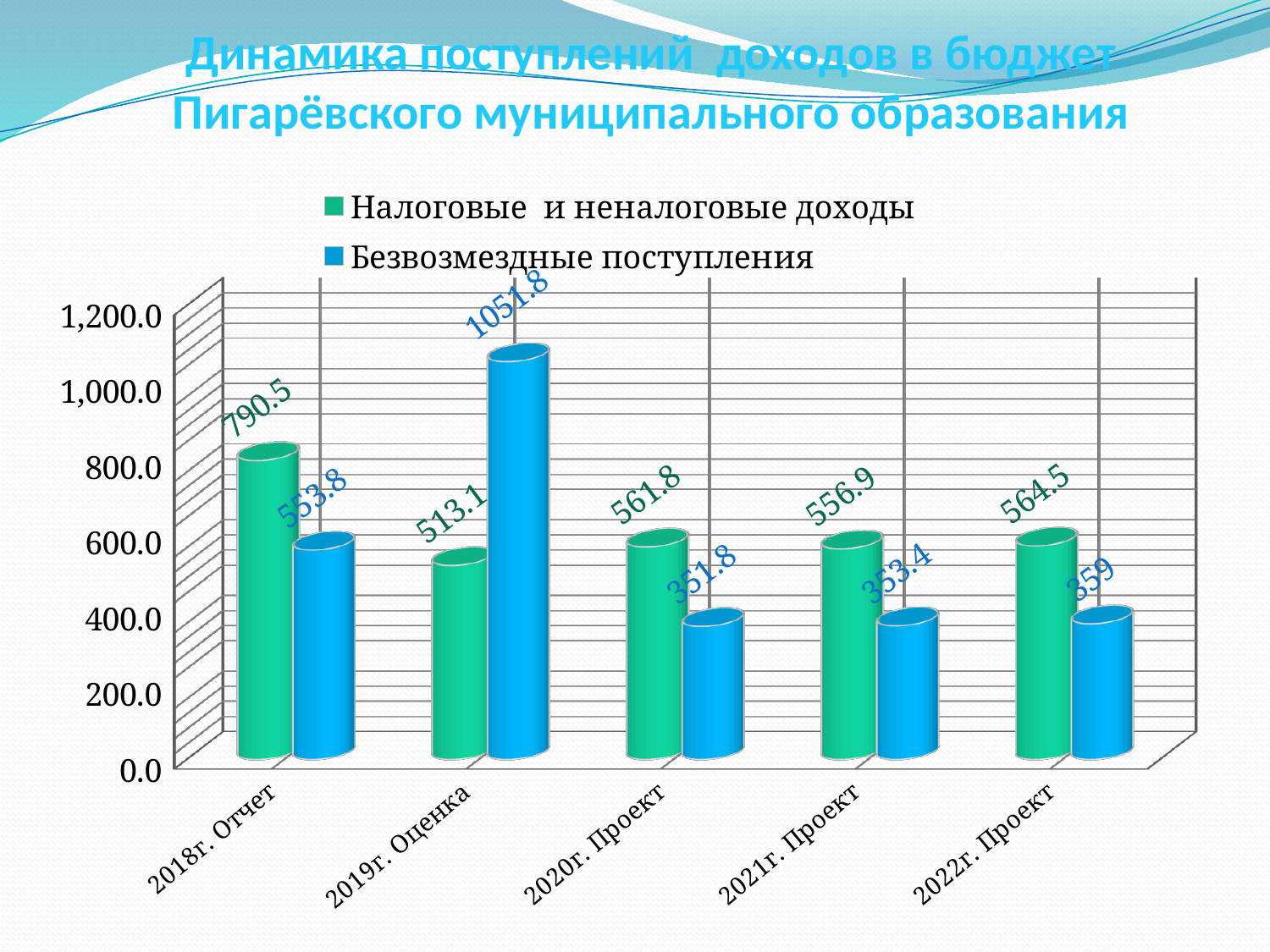
What is the value of Налоговые и неналоговые доходы for 2018г. Отчет? 790.5 Which category has the lowest value for Налоговые и неналоговые доходы? 2019г. Оценка Which is larger for 2019г. Оценка: Налоговые и неналоговые доходы or Безвозмездные поступления? Безвозмездные поступления How many categories are shown on the x axis? 5 Which category has the highest value for Безвозмездные поступления? 2019г. Оценка What is the difference between Налоговые и неналоговые доходы and Безвозмездные поступления for 2020г. Проект? 210.0 What is the value of Безвозмездные поступления for 2022г. Проект? 359 What kind of chart is shown on the slide? Bar chart How many series does the legend list? 2 What is the value of Налоговые и неналоговые доходы for 2021г. Проект? 556.9 What colour represents Безвозмездные поступления in the legend? Blue What is the value of Безвозмездные поступления for 2019г. Оценка? 1051.8